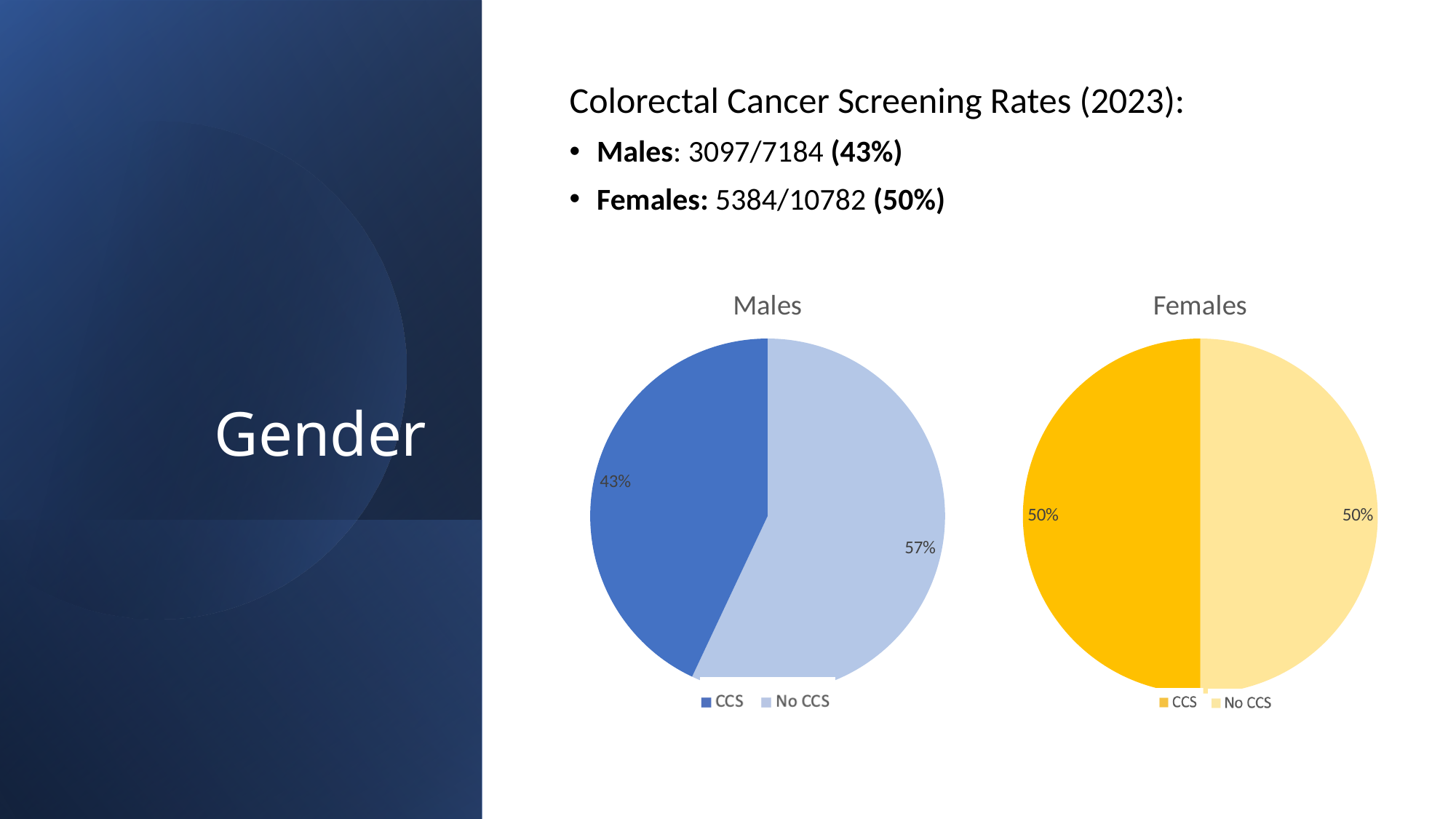
How many slices does the Males pie chart have? 2 In the Females chart, what share of the pie is labelled No CCS? 50% What kind of chart is the Females chart? Pie chart What kind of chart is the Males chart? Pie chart In the Females chart, what share of the pie is labelled CCS? 50% In the Males chart, which slice is larger, CCS or No CCS? No CCS In the Males chart, what share of the pie is labelled No CCS? 57% In the Males chart, what is the difference in percentage points between the No CCS slice and the CCS slice? 14 What is the title of the chart on the right? Females How many entries does the legend of the Females chart list? 2 In the Males chart, which legend entry is shown in the darker blue colour? CCS